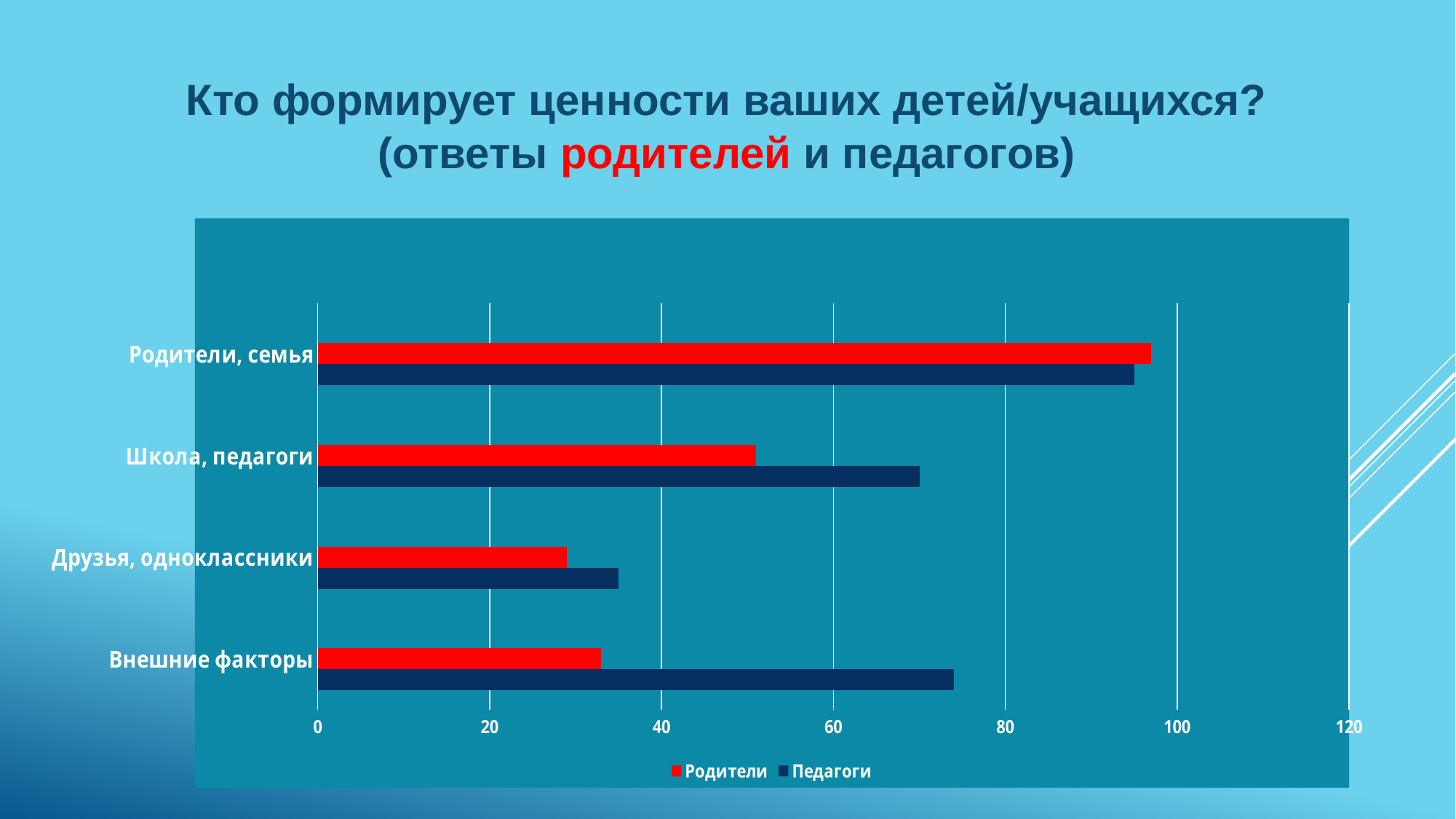
What kind of chart is shown on the slide? Bar chart Is the Родители value for Друзья, одноклассники greater or less than 40? less Which series is shown in red in the legend? Родители Which category has the highest value for the Родители series? Родители, семья Is the Родители value for Школа, педагоги greater or less than 40? greater For Школа, педагоги, which series has the larger value: Родители or Педагоги? Педагоги Which category has the highest value for the Педагоги series? Родители, семья Which category has the lowest value for the Педагоги series? Друзья, одноклассники For Внешние факторы, which series has the larger value: Родители or Педагоги? Педагоги How many series does the legend list? 2 Is the Педагоги value for Внешние факторы greater or less than 60? greater How many categories are shown on the chart? 4